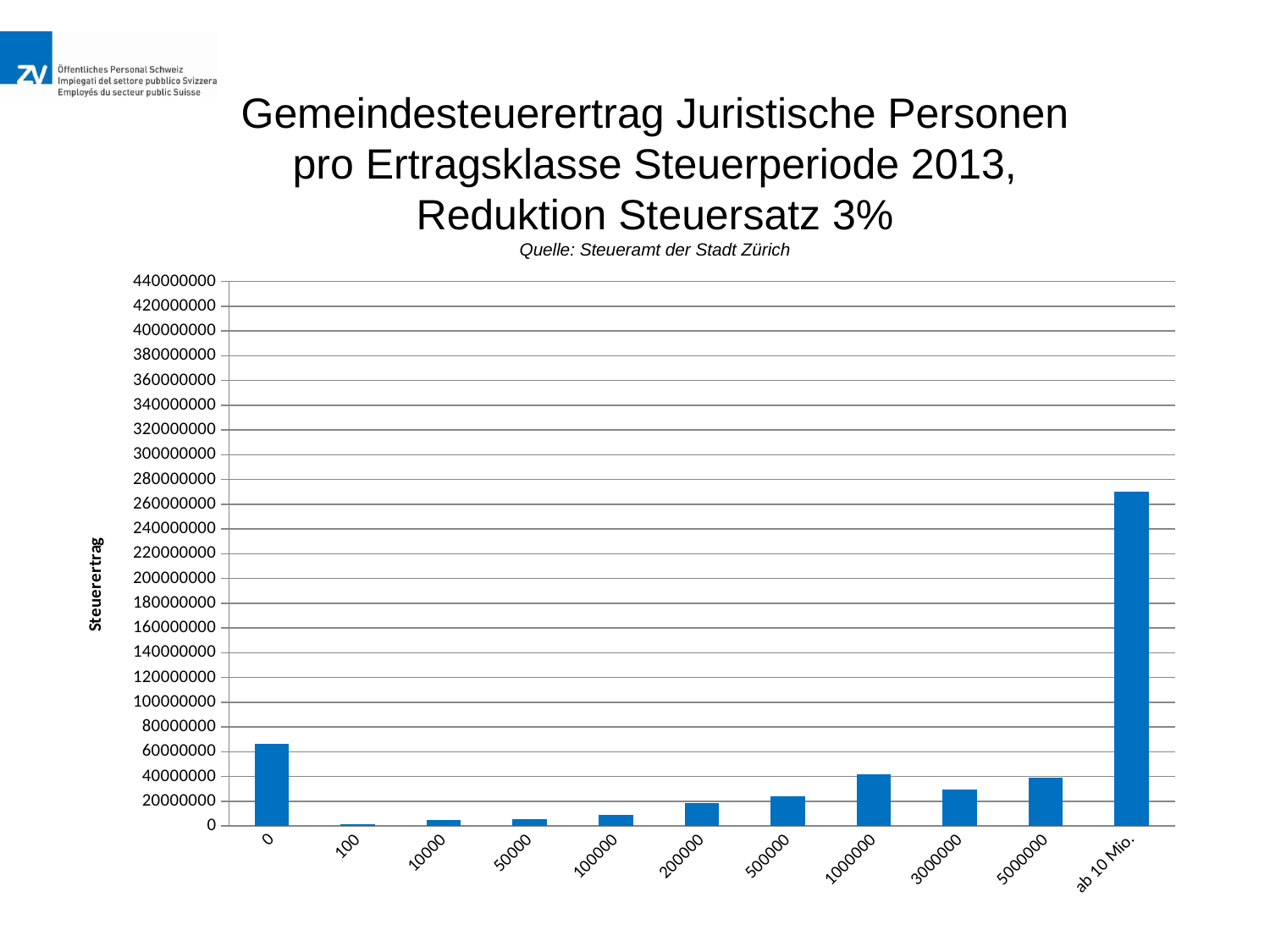
Is the value for 'ab 10 Mio.' greater or less than 260000000? greater What source is cited below the chart title? Quelle: Steueramt der Stadt Zürich Which is larger, the value for '0' or the value for '1000000'? 0 What is the label of the y axis? Steuerertrag Which category has the highest Steuerertrag? ab 10 Mio. What kind of chart is shown on the slide? bar chart Which is larger, the value for '5000000' or the value for '3000000'? 5000000 Is the value for '0' greater or less than 80000000? less How many categories (Ertragsklassen) are shown on the x axis? 11 Which category has the lowest Steuerertrag? 100